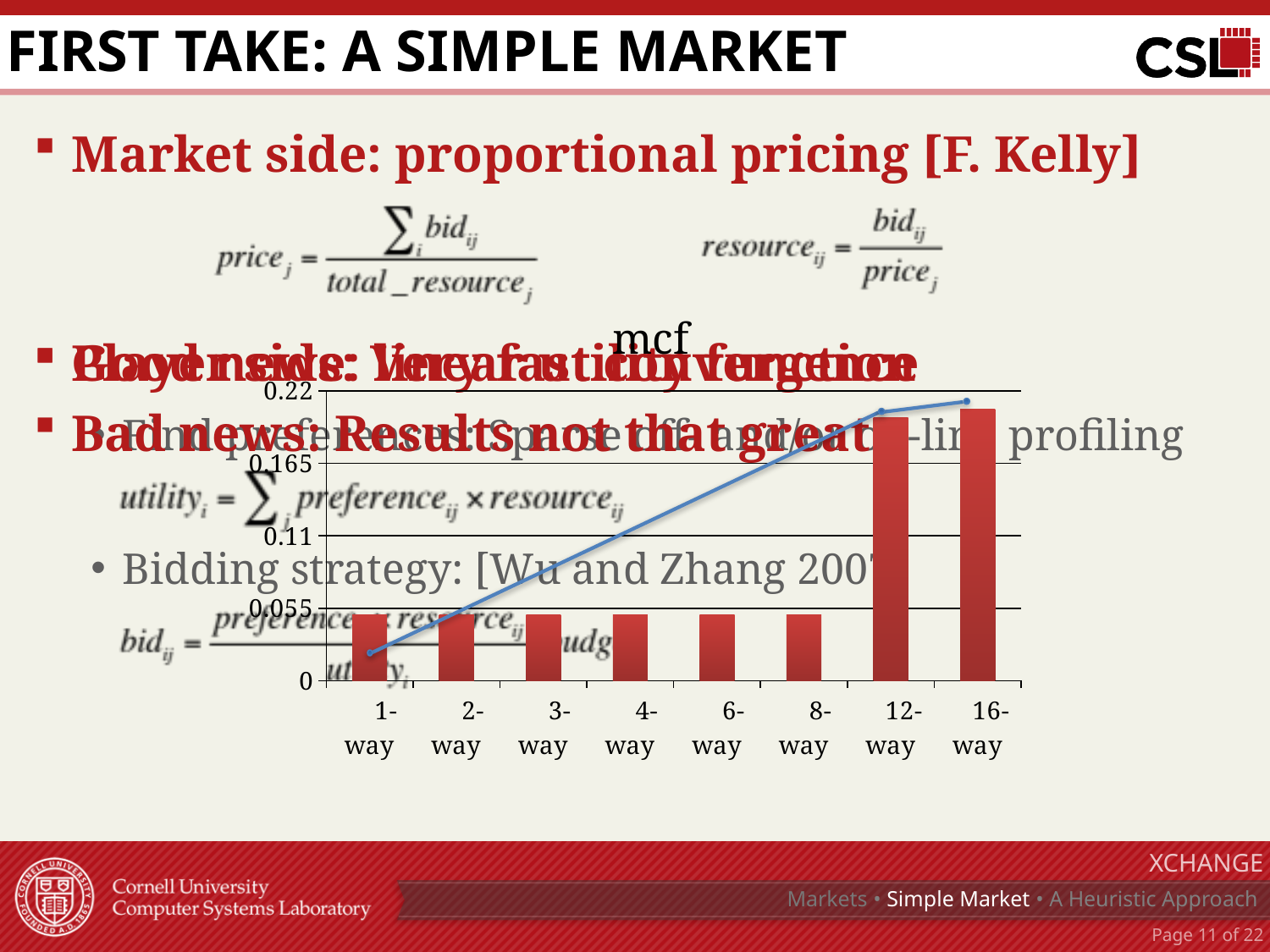
How many categories are shown on the x axis of the mcf chart? 8 In the mcf chart, is the value for 8-way greater or less than 0.165? less In the mcf chart, which is larger, the bar for 12-way or the bar for 4-way? 12-way In the mcf chart, is the value for 12-way greater or less than 0.165? greater What kind of chart is the mcf chart? bar chart In the mcf chart, which is larger, the bar for 2-way or the bar for 16-way? 16-way What is the title of the chart on the slide? mcf In the mcf chart, is the value for 1-way greater or less than 0.11? less What is the label of the first category on the x axis of the mcf chart? 1-way In the mcf chart, do the bar values generally rise or fall from 1-way to 16-way? rise What is the highest tick value shown on the y axis of the mcf chart? 0.22